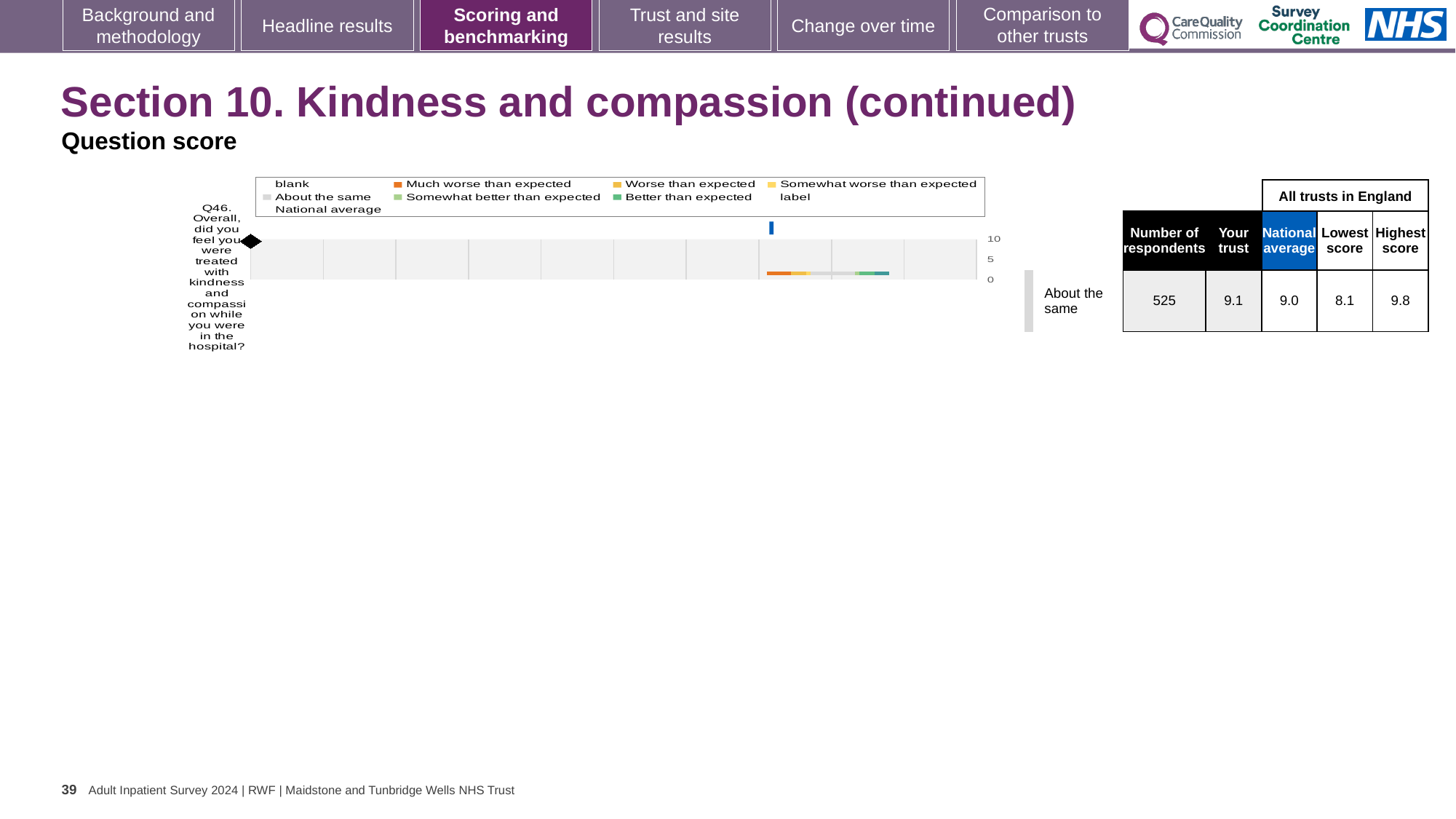
What is the difference between the highest score and the lowest score for Q46 in the table beside the chart? 1.7 What kind of chart is shown on the slide? bar chart What is the highest tick value shown on the chart's axis? 10 How many question categories are plotted on the chart? 1 According to the table beside the chart, what is the lowest score among all trusts in England for Q46? 8.1 Which is larger for Q46, the 'Your trust' score or the national average? Your trust How many entries does the chart legend list? 9 According to the table beside the chart, what is the 'Your trust' score for Q46? 9.1 According to the table beside the chart, what is the national average score for Q46? 9.0 Which question number is plotted on the chart? Q46 According to the table beside the chart, what is the highest score among all trusts in England for Q46? 9.8 According to the table beside the chart, how many respondents answered Q46? 525